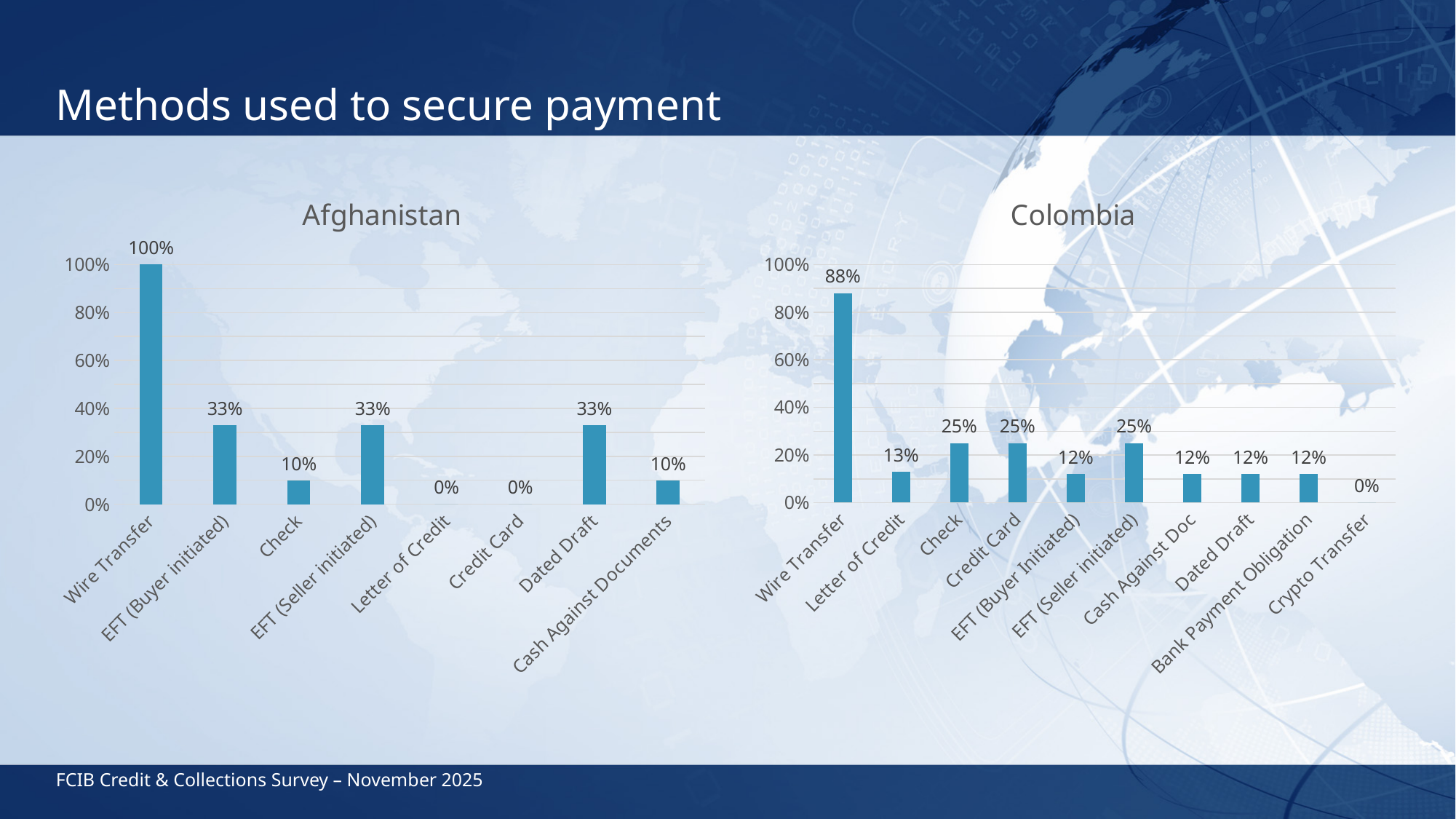
In the Colombia chart, what is the difference between Check and Letter of Credit? 12% In the Colombia chart, which category has the lowest value? Crypto Transfer In the Afghanistan chart, which category has the highest value? Wire Transfer In the Afghanistan chart, what is the value for Wire Transfer? 100% In the Colombia chart, what is the value for Wire Transfer? 88% In the Afghanistan chart, which is larger: EFT (Buyer initiated) or Check? EFT (Buyer initiated) How many categories are shown in the Afghanistan chart? 8 In the Afghanistan chart, what is the value for Check? 10% In the Colombia chart, what is the difference between Wire Transfer and Check? 63% In the Colombia chart, what is the value for Letter of Credit? 13% What kind of chart is the Afghanistan chart? Bar chart How many categories are shown in the Colombia chart? 10